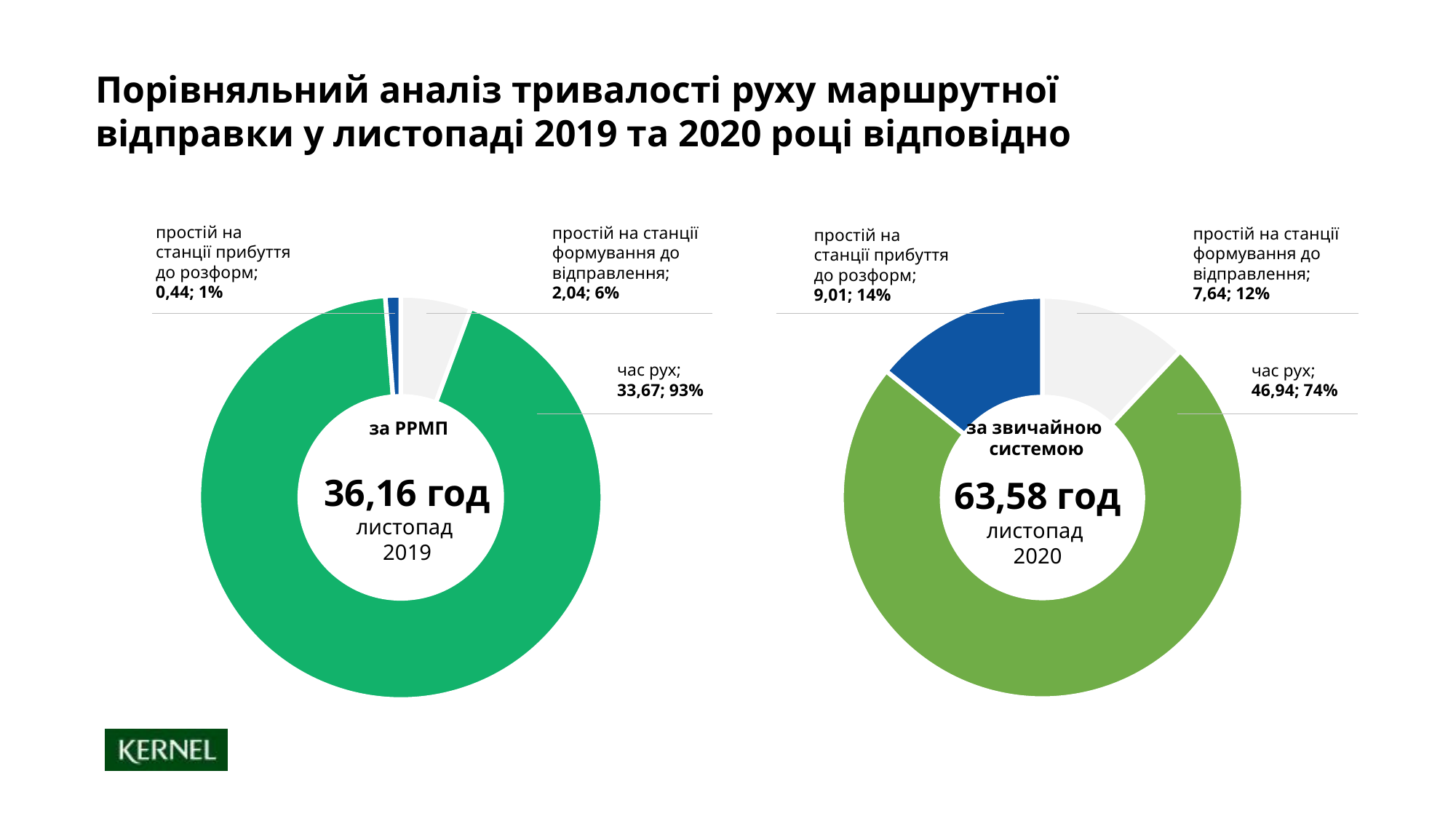
What is the difference between "час рух" in the right chart (46,94) and "час рух" in the left chart (33,67)? 13,27 In the right chart (листопад 2020), which category has the largest value? час рух What is the total duration shown in the centre of the right chart (листопад 2020)? 63,58 год What is the total duration shown in the centre of the left chart (листопад 2019)? 36,16 год In the left chart (листопад 2019, за РРМП), what is the value for "час рух"? 33,67 How many slices does each donut chart on the slide have? 3 In the right chart (листопад 2020, за звичайною системою), what is the value for "простій на станції прибуття до розформ"? 9,01 Which is larger: "простій на станції прибуття до розформ" in the right chart (листопад 2020) or "простій на станції формування до відправлення" in the same chart? простій на станції прибуття до розформ In the left chart (листопад 2019), what share of the total does "простій на станції формування до відправлення" represent? 6% In the left chart (листопад 2019), which category has the smallest value? простій на станції прибуття до розформ In the right chart (листопад 2020), what share of the total does "час рух" represent? 74% What type of chart is used on this slide? Donut (pie) chart